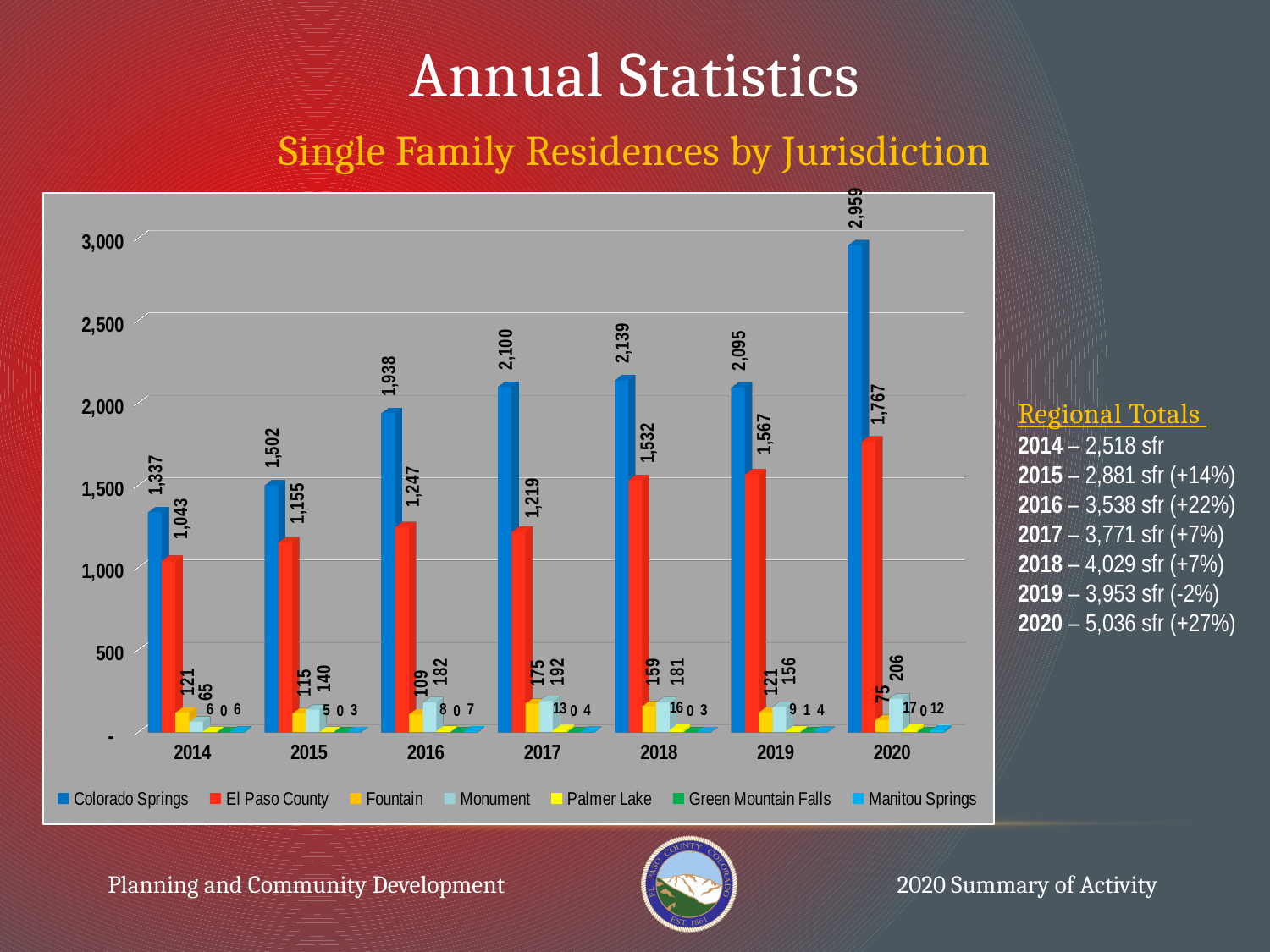
How many years are shown on the x axis? 7 What is the value for El Paso County in 2018? 1,532 What kind of chart is shown on the slide? Bar chart What is the value for Colorado Springs in 2020? 2,959 What is the value for Monument in 2017? 192 In which year is the Colorado Springs value highest? 2020 In which year is the Fountain value lowest? 2020 Which series is shown in red in the legend? El Paso County What is the difference between the Colorado Springs and El Paso County values in 2020? 1,192 Which is larger in 2016, Fountain or Monument? Monument Is the value for Colorado Springs in 2019 greater or less than 2,000? greater How many series does the legend list? 7